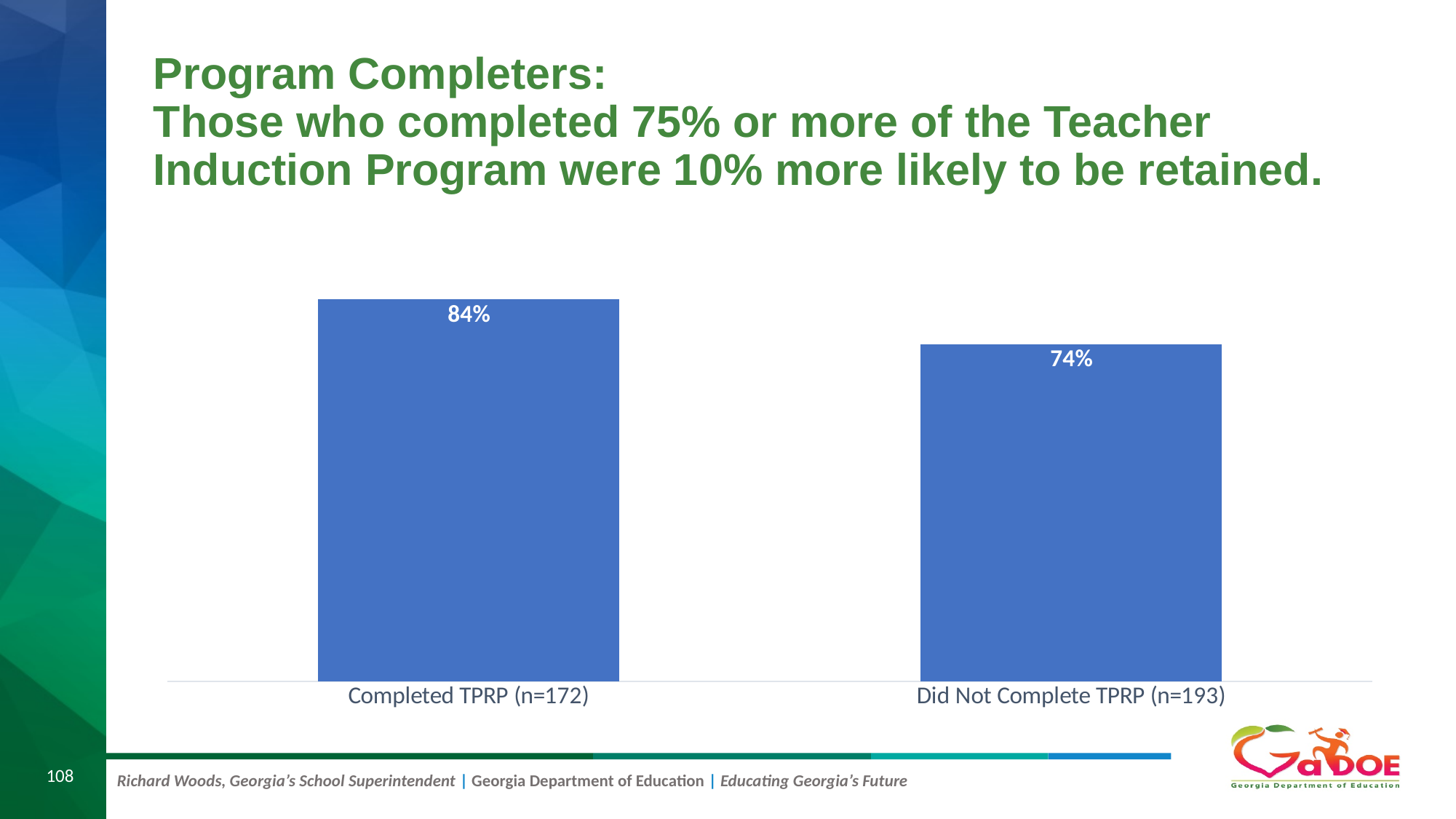
Do the values rise or fall from left to right across the categories? Fall What is the sample size (n) shown for the Did Not Complete TPRP category? 193 What is the value for Completed TPRP (n=172)? 84% Which is larger, the value for Completed TPRP (n=172) or the value for Did Not Complete TPRP (n=193)? Completed TPRP (n=172) What colour are the bars in the chart? Blue Which category has the lowest value? Did Not Complete TPRP (n=193) What is the value for Did Not Complete TPRP (n=193)? 74% Which category has the highest value? Completed TPRP (n=172) How many categories are shown in the chart? 2 What kind of chart is shown on the slide? Bar chart What is the difference between the values for Completed TPRP (n=172) and Did Not Complete TPRP (n=193)? 10%